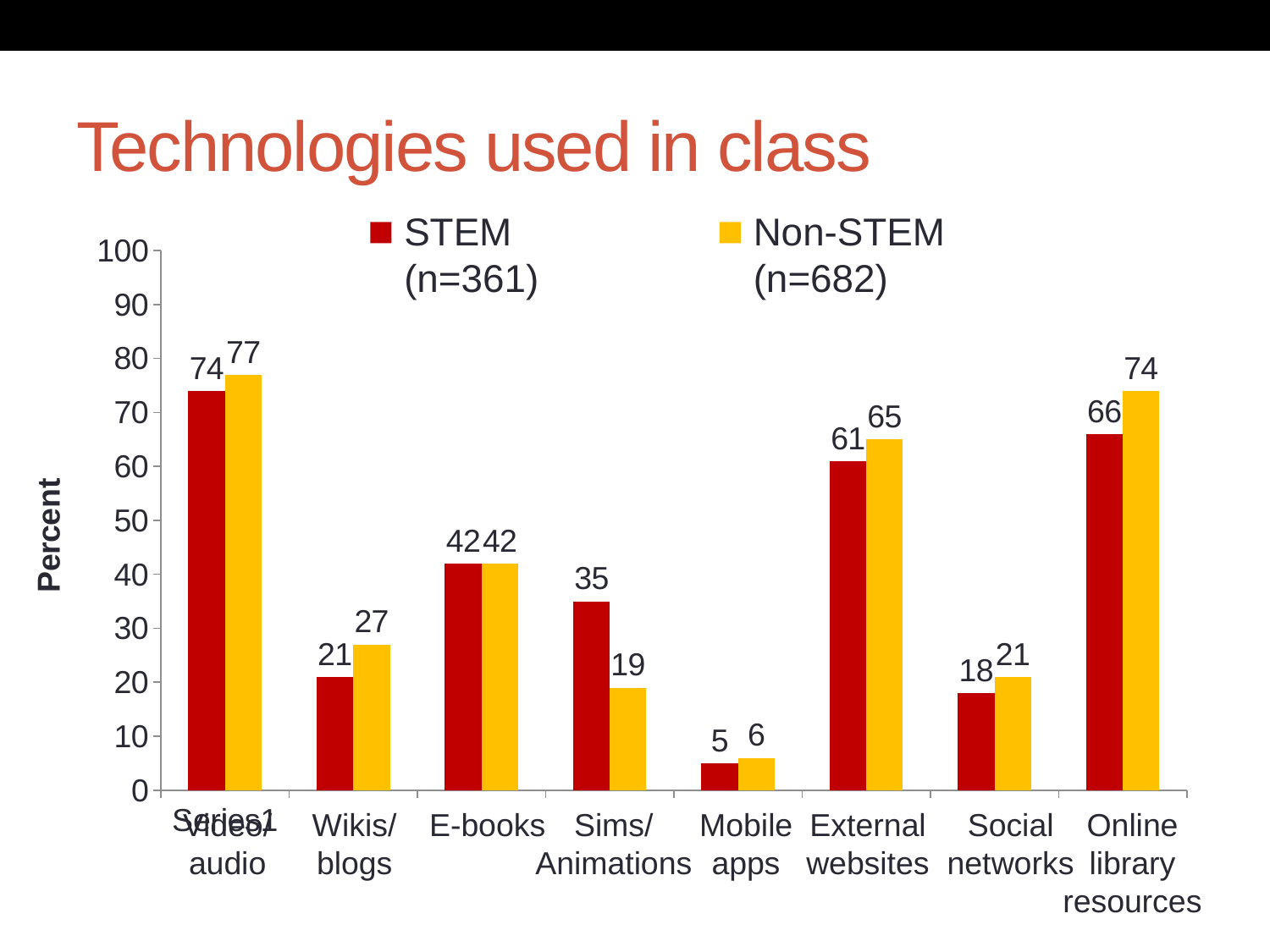
How many categories are shown on the x axis? 8 Which is larger for Wikis/blogs, the STEM value or the Non-STEM value? Non-STEM What is the STEM value for Sims/Animations? 35 How many series does the legend list? 2 What is the STEM value for E-books? 42 What is the difference between the STEM and Non-STEM values for Sims/Animations? 16 Which category has the highest Non-STEM value? Video/audio What is the difference between the Non-STEM and STEM values for Online library resources? 8 What is the label of the y axis? Percent Which category has the lowest STEM value? Mobile apps What kind of chart is shown on the slide? Bar chart What is the Non-STEM value for External websites? 65